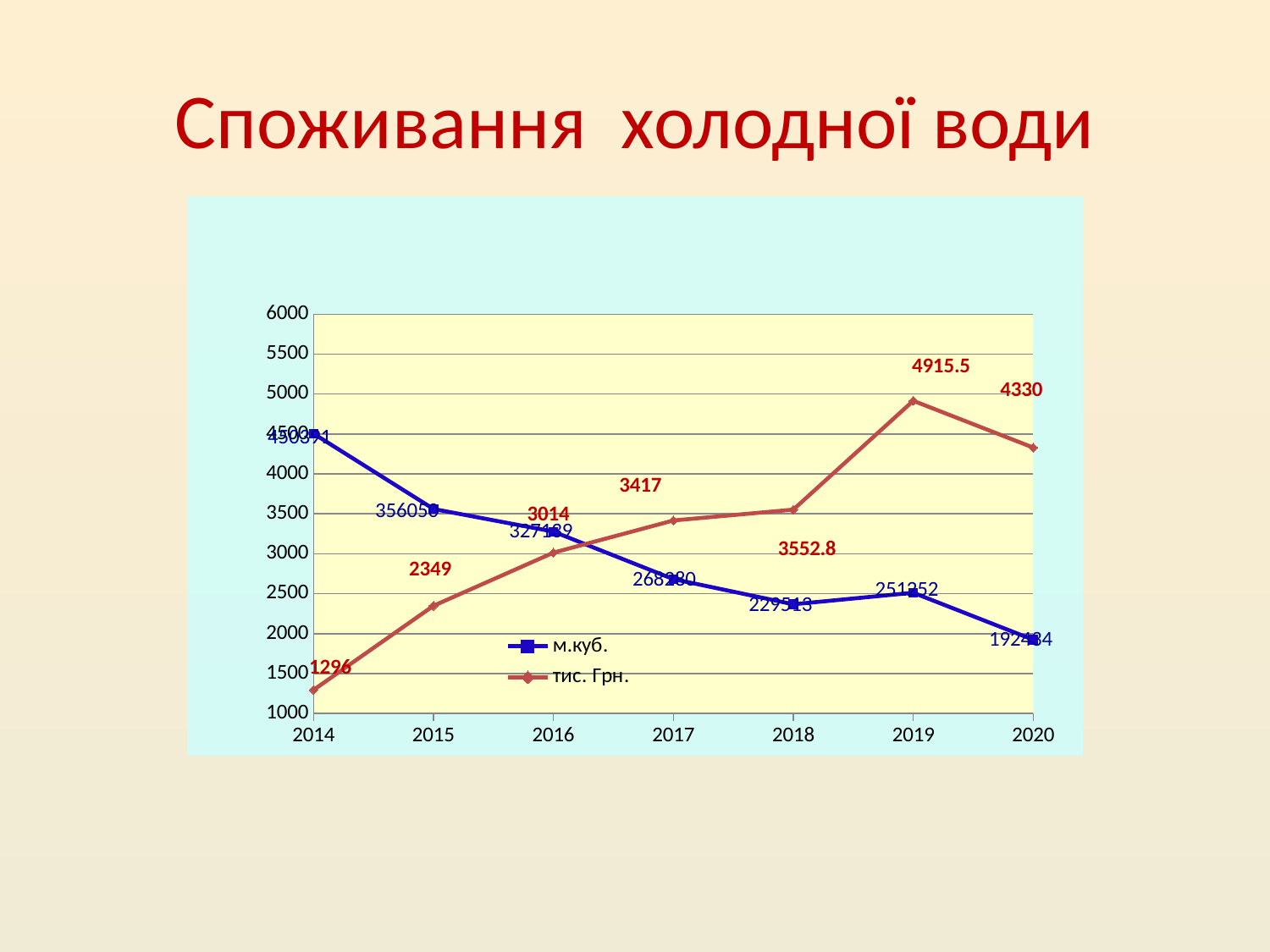
How many series does the legend list? 2 In 2020, which series has the larger value, м.куб. or тис. Грн.? тис. Грн. What kind of chart is shown on the slide? line chart What is the value of the тис. Грн. series in 2014? 1296 How many years are plotted along the x axis? 7 In which year is the тис. Грн. series highest? 2019 In which year is the тис. Грн. series lowest? 2014 Does the м.куб. series generally rise or fall from 2014 to 2020? fall By how much did the тис. Грн. value fall from 2019 to 2020? 585.5 What is the value of the тис. Грн. series in 2019? 4915.5 What is the value of the тис. Грн. series in 2018? 3552.8 Is the value of the м.куб. series in 2018 greater or less than 2500? less